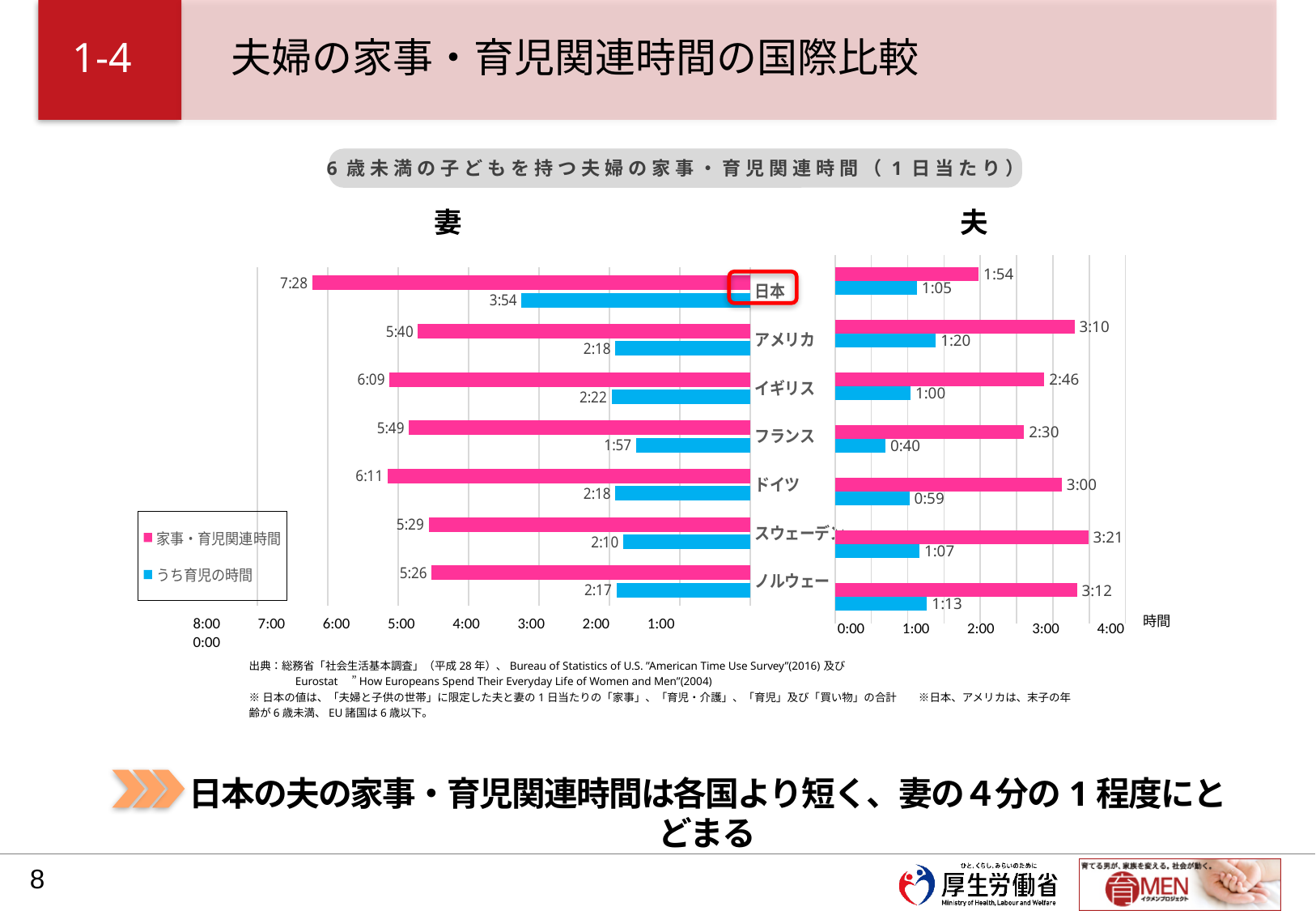
In the 妻 chart, what is the 家事・育児関連時間 value for 日本? 7:28 In the 夫 chart, which country has the lowest 家事・育児関連時間? 日本 In the 夫 chart, what is the うち育児の時間 value for フランス? 0:40 In the 妻 chart, which country has the lowest うち育児の時間? フランス In the 妻 chart, which is larger, the 家事・育児関連時間 for イギリス or for アメリカ? イギリス How many countries are shown in the 夫 chart? 7 In the 夫 chart, what is the 家事・育児関連時間 value for 日本? 1:54 What type of chart is the 妻 chart? Bar chart How many series does the legend list? 2 In the 夫 chart, which country has the highest 家事・育児関連時間? スウェーデン In the 夫 chart, what is the difference in 家事・育児関連時間 between スウェーデン and 日本? 1:27 In the 妻 chart, what is the うち育児の時間 value for イギリス? 2:22